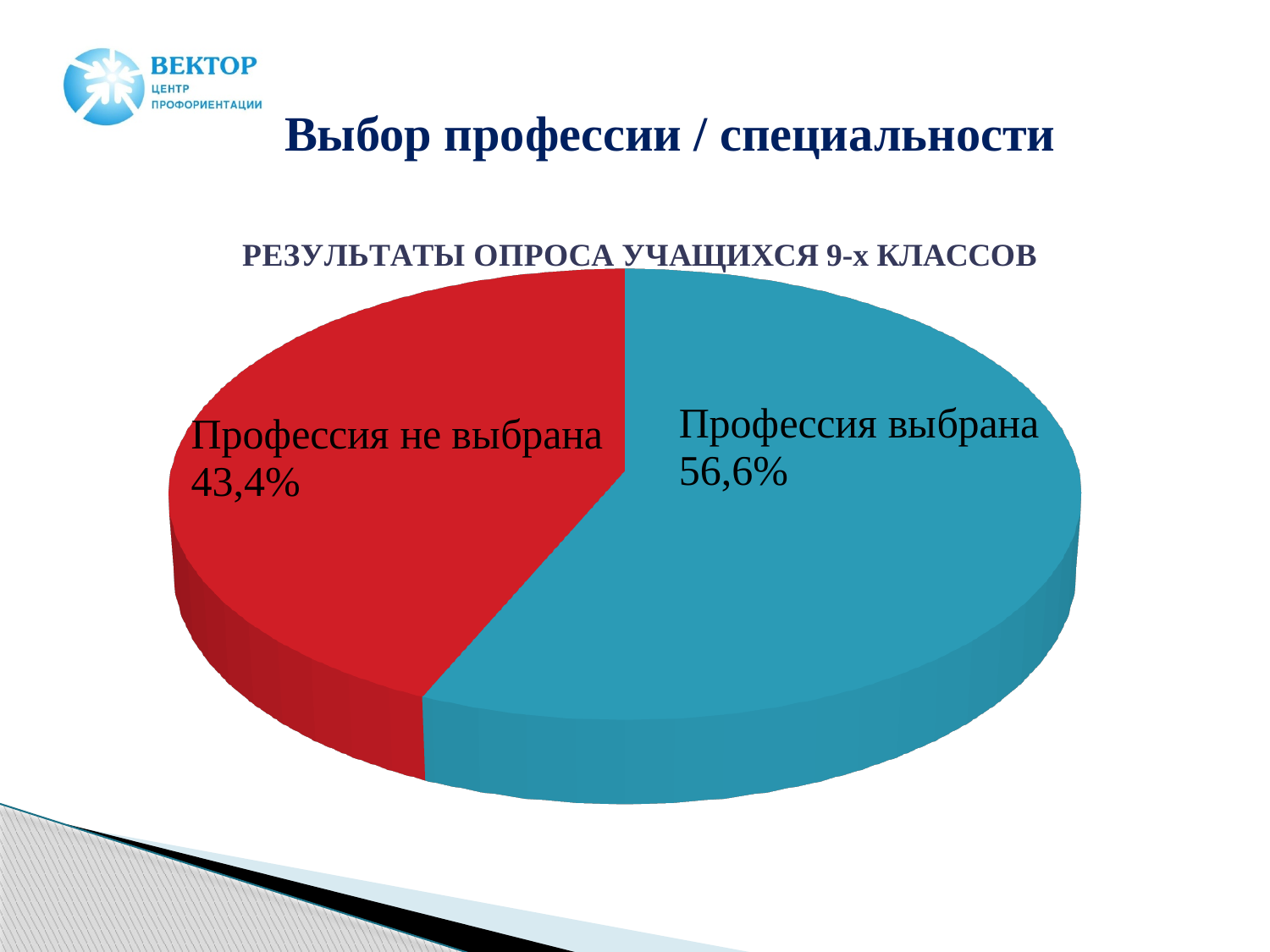
Which is larger: the share for "Профессия выбрана" or for "Профессия не выбрана"? Профессия выбрана What colour is the "Профессия не выбрана" slice? red What kind of chart is shown on the slide? pie chart What share of the pie is labelled "Профессия не выбрана"? 43,4% What is the difference in percentage points between the "Профессия выбрана" and "Профессия не выбрана" slices? 13,2% What is the title of the chart? РЕЗУЛЬТАТЫ ОПРОСА УЧАЩИХСЯ 9-х КЛАССОВ How many slices does the pie chart have? 2 Which slice of the pie is the smallest? Профессия не выбрана Which slice of the pie is the largest? Профессия выбрана What share of the pie is labelled "Профессия выбрана"? 56,6%